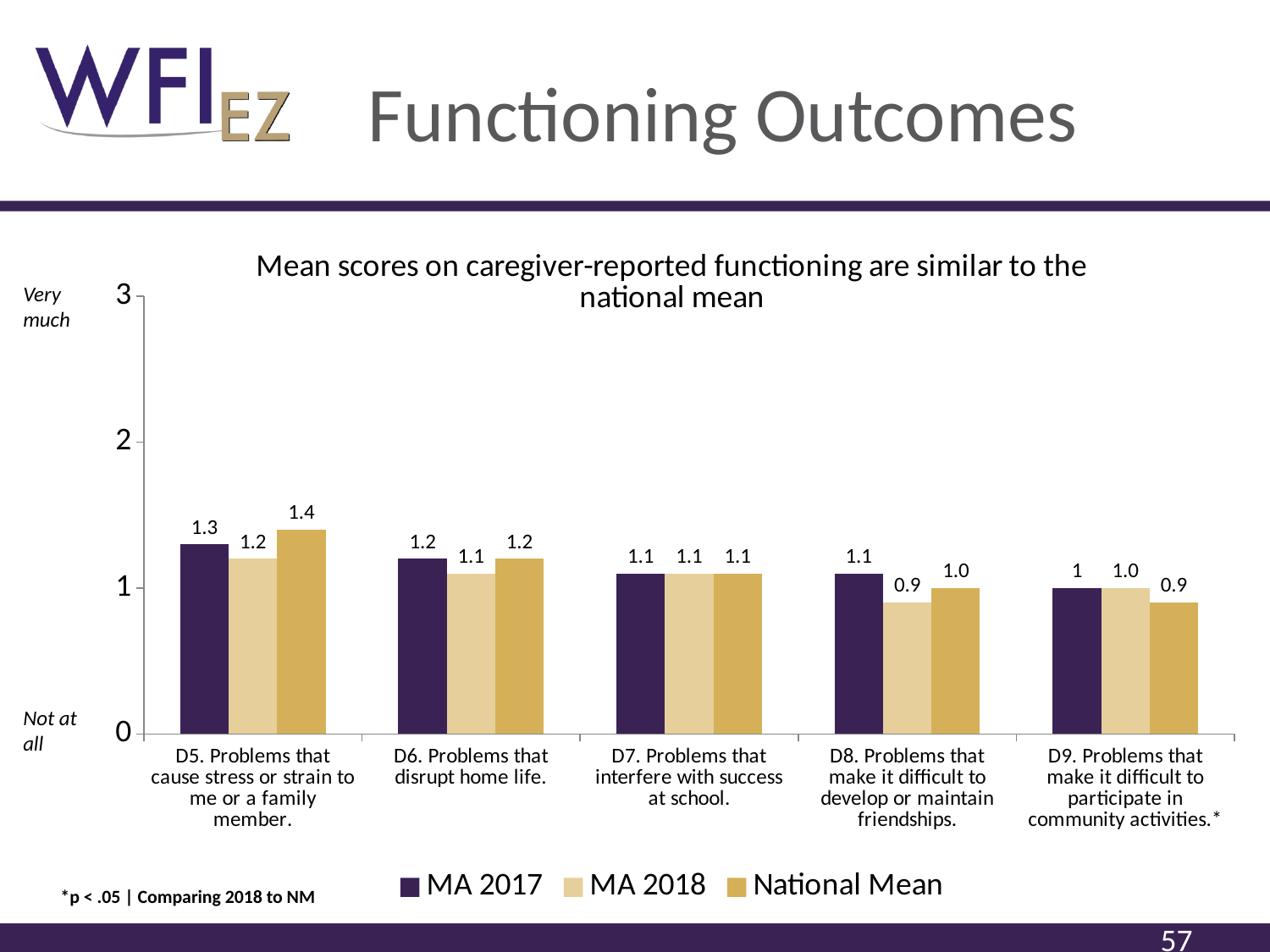
What is the National Mean value for D9. Problems that make it difficult to participate in community activities? 0.9 What is the MA 2018 value for D8. Problems that make it difficult to develop or maintain friendships? 0.9 Which category has the highest National Mean value? D5. Problems that cause stress or strain to me or a family member. What is the difference between the National Mean and MA 2018 values for D5. Problems that cause stress or strain to me or a family member? 0.2 How many categories are shown on the x axis? 5 What is the MA 2017 value for D5. Problems that cause stress or strain to me or a family member? 1.3 Is the MA 2017 value for D6. Problems that disrupt home life greater or less than 2? less How many series does the legend list? 3 For D8. Problems that make it difficult to develop or maintain friendships, which is larger: the MA 2017 value or the MA 2018 value? MA 2017 What is the title of the chart? Mean scores on caregiver-reported functioning are similar to the national mean What is the National Mean value for D5. Problems that cause stress or strain to me or a family member? 1.4 What kind of chart is shown on the slide? Bar chart